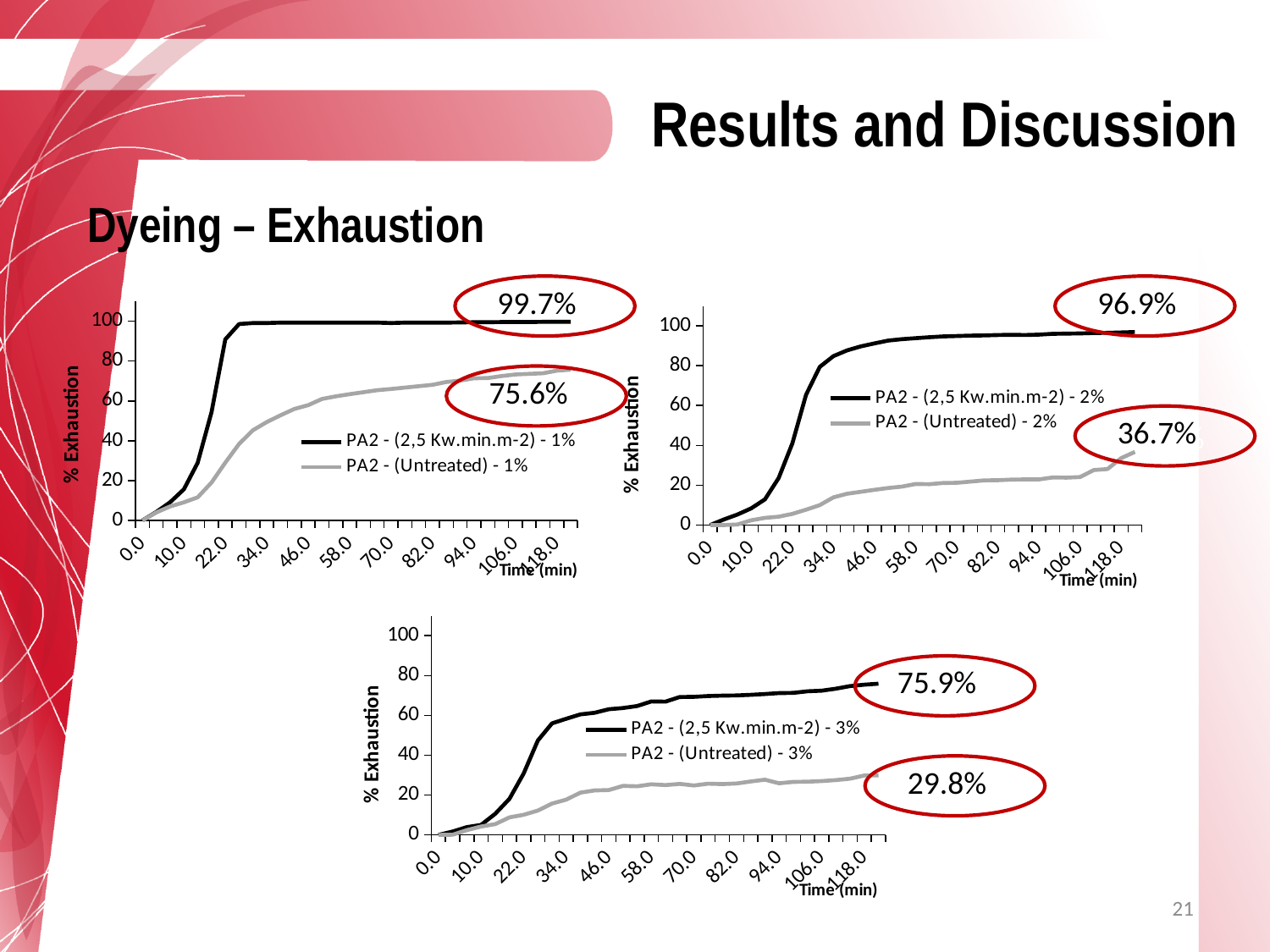
What kind of chart is the bottom chart? Line chart On the bottom chart, what is the final exhaustion value circled for the PA2 - (Untreated) - 3% series? 29.8% On the bottom chart, what is the difference between the final exhaustion values of the treated and untreated series? 46.1% On the top-right chart, what is the final exhaustion value circled for the PA2 - (2,5 Kw.min.m-2) - 2% series? 96.9% On the bottom chart, what is the final exhaustion value circled for the PA2 - (2,5 Kw.min.m-2) - 3% series? 75.9% On the top-right chart, what is the final exhaustion value circled for the PA2 - (Untreated) - 2% series? 36.7% On the bottom chart, does the exhaustion of the PA2 - (2,5 Kw.min.m-2) - 3% series rise or fall as time increases? Rise How many series does the legend of the top-right chart list? 2 On the top-right chart, what is the difference between the final exhaustion values of the treated and untreated series? 60.2% On the top-left chart, what is the final exhaustion value circled for the PA2 - (2,5 Kw.min.m-2) - 1% series? 99.7% On the top-left chart, which series reaches the higher final exhaustion, the treated (2,5 Kw.min.m-2) or the untreated? PA2 - (2,5 Kw.min.m-2) - 1% On the top-left chart, what is the final exhaustion value circled for the PA2 - (Untreated) - 1% series? 75.6%